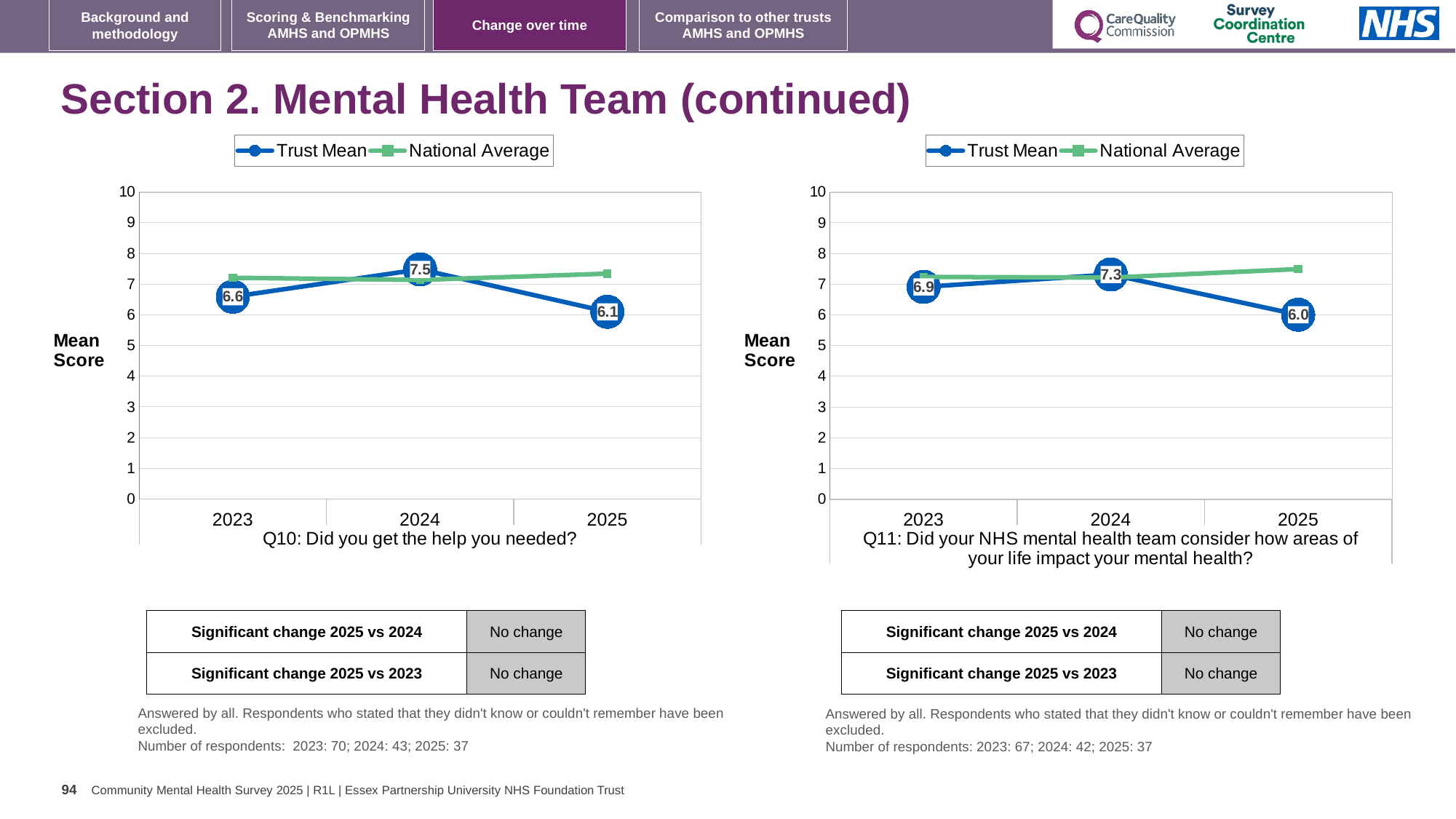
In the Q11 chart (Did your NHS mental health team consider how areas of your life impact your mental health?), is the Trust Mean for 2025 larger or smaller than the National Average for 2025? smaller In the Q10 chart (Did you get the help you needed?), what is the Trust Mean for 2024? 7.5 In the Q11 chart (Did your NHS mental health team consider how areas of your life impact your mental health?), which year has the highest Trust Mean? 2024 In the Q11 chart (Did your NHS mental health team consider how areas of your life impact your mental health?), how many years are plotted on the x axis? 3 How many series does the legend of the Q10 chart (Did you get the help you needed?) list? 2 In the Q10 chart (Did you get the help you needed?), what is the Trust Mean for 2025? 6.1 In the Q10 chart (Did you get the help you needed?), is the National Average for 2025 greater or less than 7? greater In the Q10 chart (Did you get the help you needed?), what is the difference between the Trust Mean for 2024 and 2025? 1.4 In the Q11 chart (Did your NHS mental health team consider how areas of your life impact your mental health?), what is the difference between the Trust Mean for 2024 and 2025? 1.3 What kind of chart is the Q10 chart (Did you get the help you needed?)? Line chart In the Q10 chart (Did you get the help you needed?), which year has the lowest Trust Mean? 2025 In the Q11 chart (Did your NHS mental health team consider how areas of your life impact your mental health?), what is the Trust Mean for 2023? 6.9